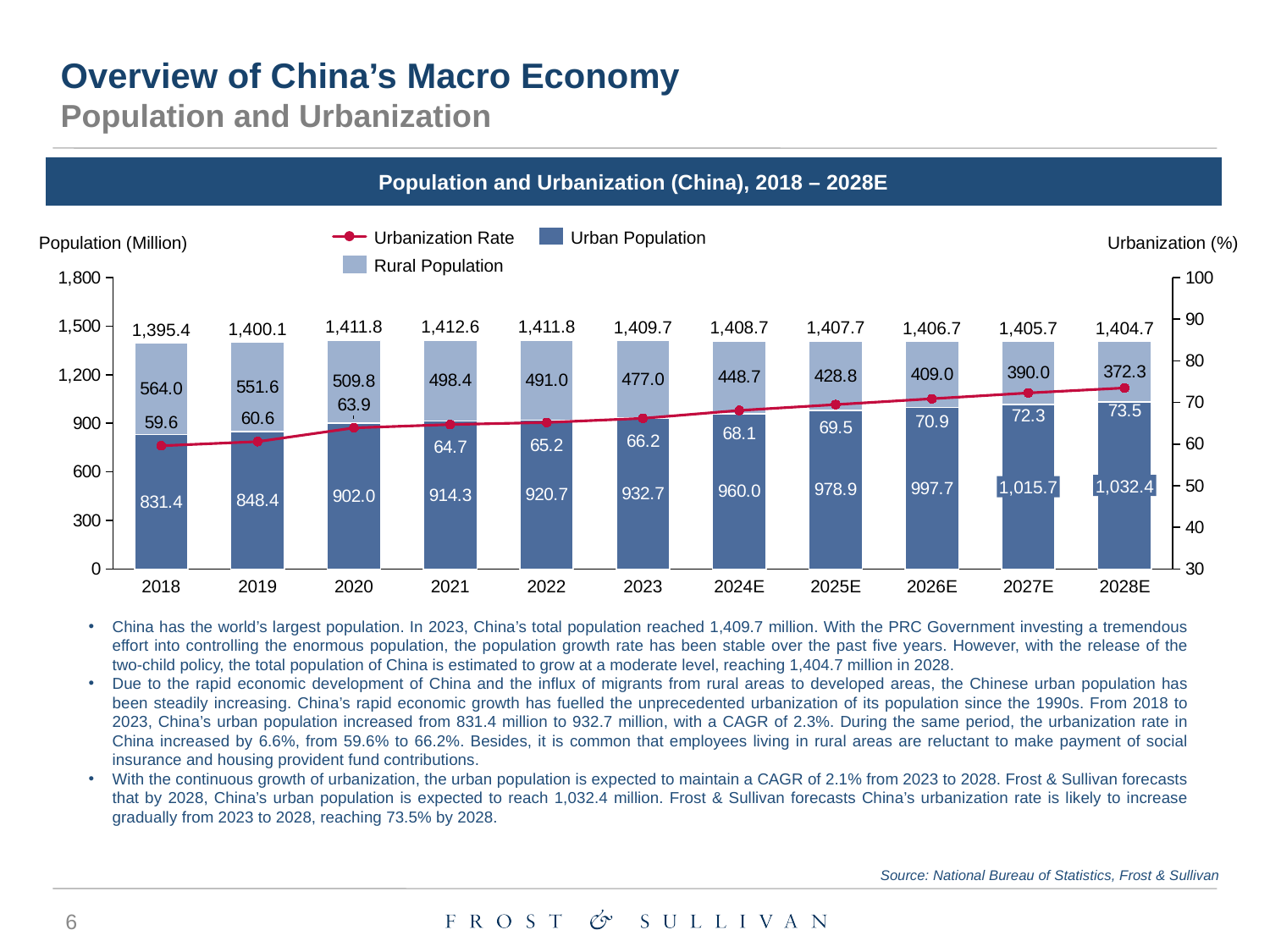
What is the rural population for 2018? 564.0 What is the total population shown above the bar for 2021? 1,412.6 What is the title of the chart? Population and Urbanization (China), 2018 – 2028E What is the difference between the urban population in 2028E and in 2018? 201.0 What is the urban population for 2023? 932.7 Which year has the lowest rural population? 2028E How many series does the legend list? 3 Does the urbanization rate rise or fall from 2018 to 2028E? rise Is the rural population larger in 2019 or in 2025E? 2019 Which year has the highest urban population? 2028E What is the urbanization rate for 2028E? 73.5 How many years are shown on the x axis? 11